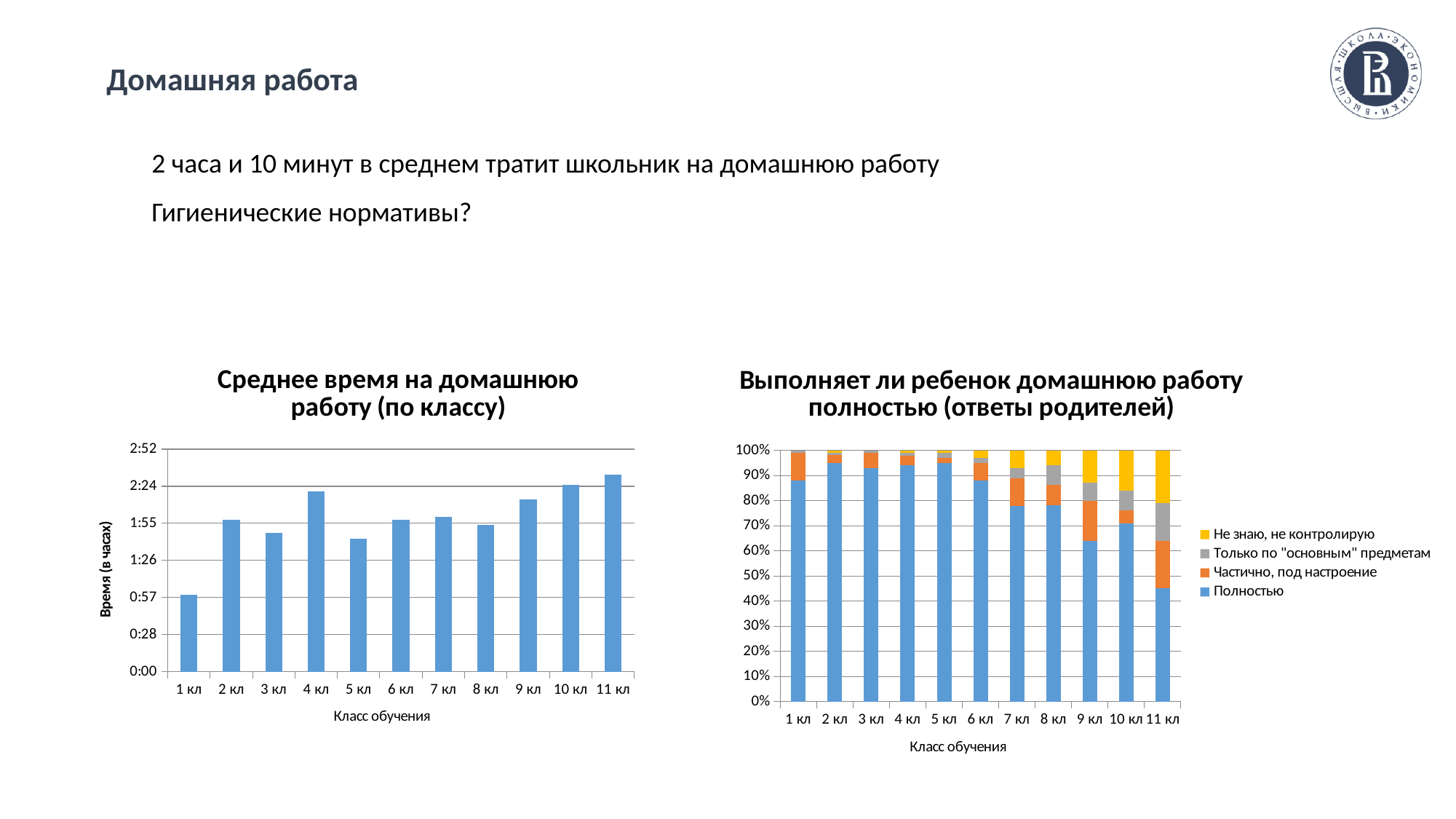
On the left chart 'Среднее время на домашнюю работу (по классу)', which grade has the lowest average homework time? 1 кл On the left chart 'Среднее время на домашнюю работу (по классу)', is the value for 4 кл greater or less than 1:55? greater On the right chart 'Выполняет ли ребенок домашнюю работу полностью (ответы родителей)', is the 'Полностью' share for 11 кл greater or less than 50%? less On the left chart 'Среднее время на домашнюю работу (по классу)', how many grades are shown on the x axis? 11 On the left chart 'Среднее время на домашнюю работу (по классу)', which grade has a larger value, 4 кл or 5 кл? 4 кл On the left chart 'Среднее время на домашнюю работу (по классу)', is the value for 1 кл greater or less than 1:26? less On the right chart 'Выполняет ли ребенок домашнюю работу полностью (ответы родителей)', which grade has the smallest 'Полностью' share? 11 кл What kind of chart is the right chart 'Выполняет ли ребенок домашнюю работу полностью (ответы родителей)'? stacked bar chart On the left chart 'Среднее время на домашнюю работу (по классу)', which grade has the highest average homework time? 11 кл On the left chart 'Среднее время на домашнюю работу (по классу)', what is the title of the vertical axis? Время (в часах) On the right chart 'Выполняет ли ребенок домашнюю работу полностью (ответы родителей)', how many series does the legend list? 4